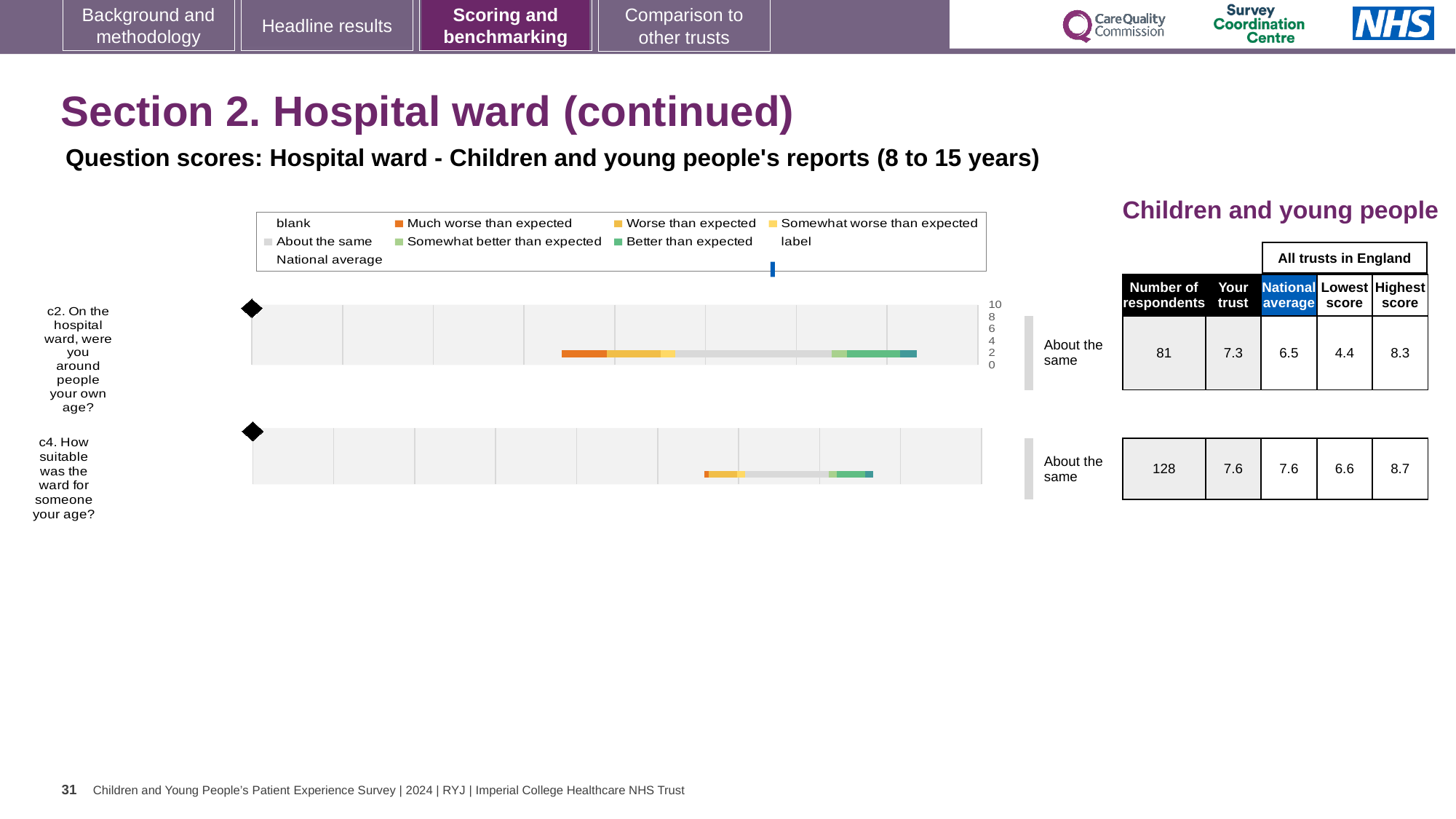
What benchmark category is shown for question c2? About the same What is the national average score for question c4 (How suitable was the ward for someone your age?)? 7.6 What kind of chart is used to show the question scores for c2 and c4? Bar chart What colour represents 'Much worse than expected' in the legend? Orange What is the 'Your trust' score for question c2 (On the hospital ward, were you around people your own age?)? 7.3 For question c4, what is the difference between the 'Your trust' score and the national average? 0 How many respondents answered question c4? 128 What is the lowest score across all trusts in England for question c4? 6.6 Which question has the higher 'Your trust' score, c2 or c4? c4 How many questions are plotted on this slide? 2 For question c2, what is the difference between the highest score and the lowest score across all trusts in England? 3.9 For question c2, which is larger: the 'Your trust' score or the national average? Your trust